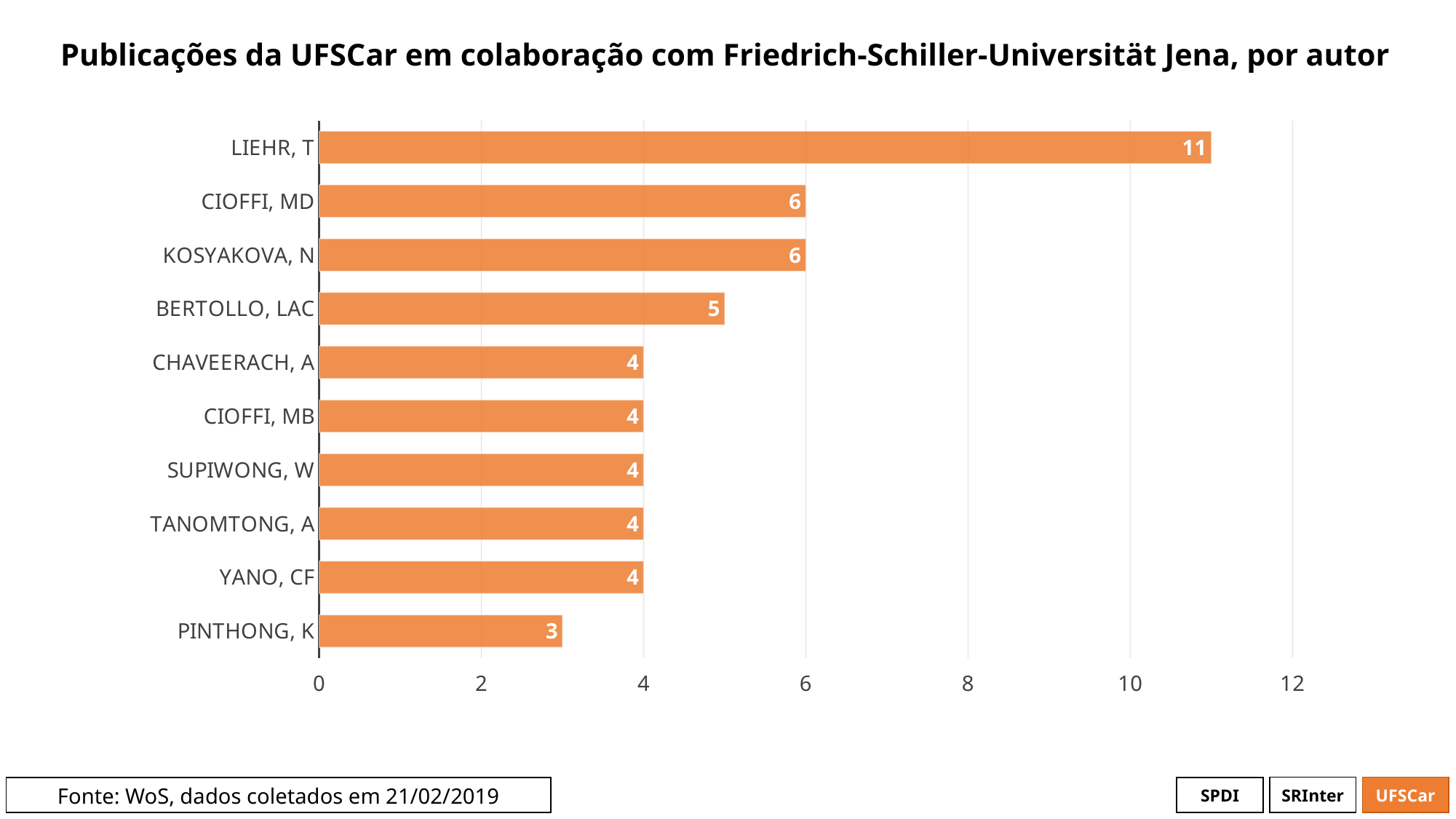
Which author has the highest number of publications? LIEHR, T What is the title of the chart? Publicações da UFSCar em colaboração com Friedrich-Schiller-Universität Jena, por autor Which is larger, the value for BERTOLLO, LAC or the value for YANO, CF? BERTOLLO, LAC Is the value for LIEHR, T greater or less than 10? greater What kind of chart is shown on the slide? bar chart What is the difference between the values for LIEHR, T and CIOFFI, MD? 5 How many authors are shown in the chart? 10 What is the value for PINTHONG, K? 3 What is the value for BERTOLLO, LAC? 5 What is the value for KOSYAKOVA, N? 6 How many publications does LIEHR, T have? 11 Which author has the lowest number of publications? PINTHONG, K